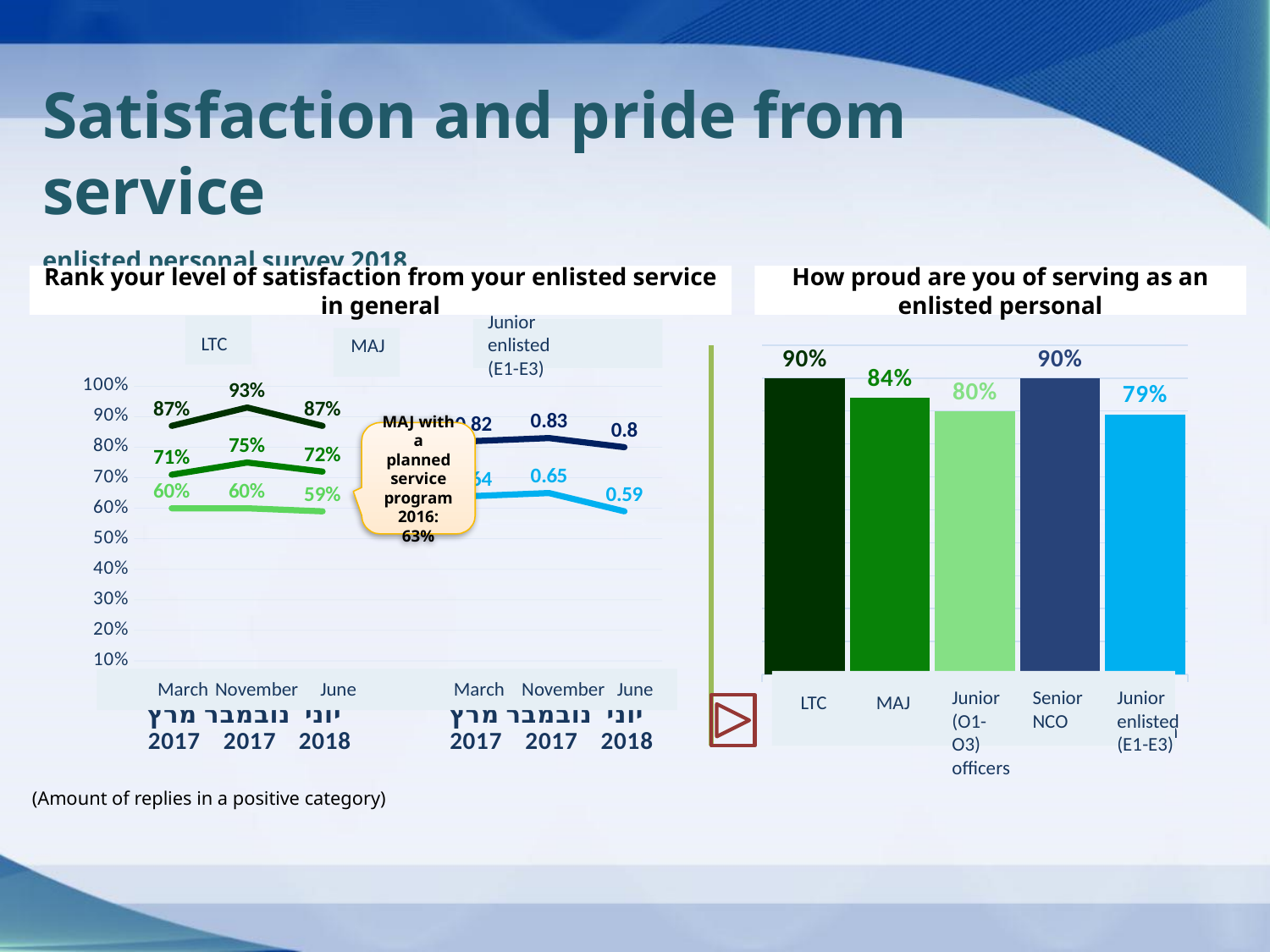
In the chart 'Rank your level of satisfaction from your enlisted service in general', what is the MAJ value for March 2017? 71% What kind of chart is 'Rank your level of satisfaction from your enlisted service in general'? Line chart In the chart 'How proud are you of serving as an enlisted personal', what is the difference between the LTC value and the Junior (O1-O3) officers value? 10% In the chart 'How proud are you of serving as an enlisted personal', how many categories are shown? 5 In the chart 'Rank your level of satisfaction from your enlisted service in general', what is the Junior enlisted (E1-E3) value for June 2018? 59% In the chart 'How proud are you of serving as an enlisted personal', which category has the lowest value? Junior enlisted (E1-E3) In the chart 'Rank your level of satisfaction from your enlisted service in general', which is larger in June 2018: the LTC value or the MAJ value? LTC What kind of chart is 'How proud are you of serving as an enlisted personal'? Bar chart In the chart 'Rank your level of satisfaction from your enlisted service in general', what is the LTC value for November 2017? 93% In the chart 'How proud are you of serving as an enlisted personal', what is the value for Junior enlisted (E1-E3)? 79% In the chart 'Rank your level of satisfaction from your enlisted service in general', what is the difference between the LTC and MAJ values in November 2017? 18% In the chart 'How proud are you of serving as an enlisted personal', what is the value for MAJ? 84%